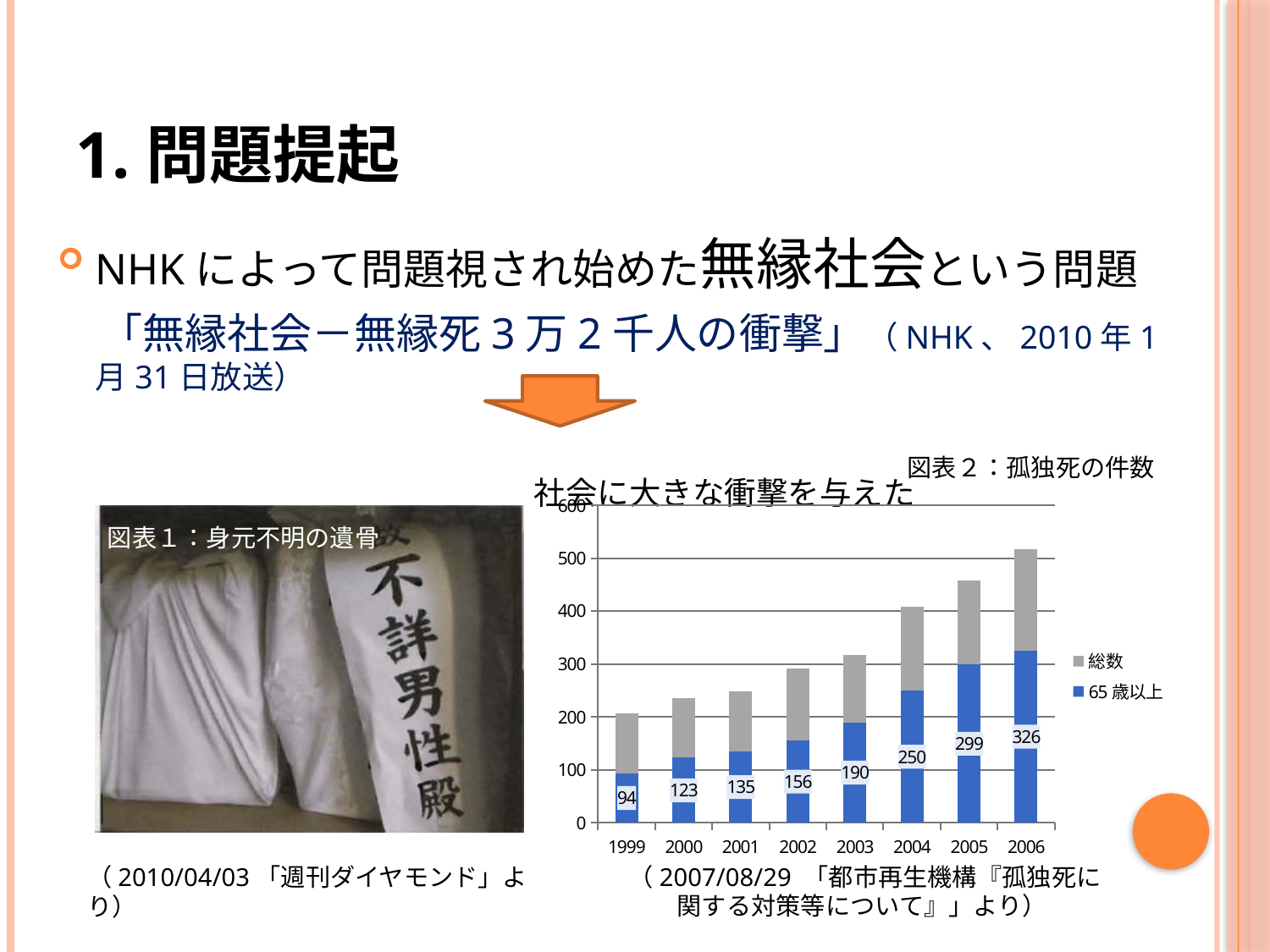
In the chart 図表２：孤独死の件数, is the total height of the 2006 bar greater or less than 500? greater How many years are shown on the x axis of the chart 図表２：孤独死の件数? 8 How many series does the legend of the chart 図表２：孤独死の件数 list? 2 What kind of chart is 図表２：孤独死の件数? bar chart In the chart 図表２：孤独死の件数, what is the value for 65歳以上 in 1999? 94 In the chart 図表２：孤独死の件数, what is the value for 65歳以上 in 2006? 326 In the chart 図表２：孤独死の件数, which is larger for 65歳以上: 2004 or 2003? 2004 In the chart 図表２：孤独死の件数, which year has the highest value for 65歳以上? 2006 In the chart 図表２：孤独死の件数, what is the difference between the 65歳以上 values for 2006 and 1999? 232 In the chart 図表２：孤独死の件数, what is the value for 65歳以上 in 2003? 190 In the chart 図表２：孤独死の件数, which year has the lowest value for 65歳以上? 1999 In the chart 図表２：孤独死の件数, is the total height of the 2005 bar greater or less than 500? less